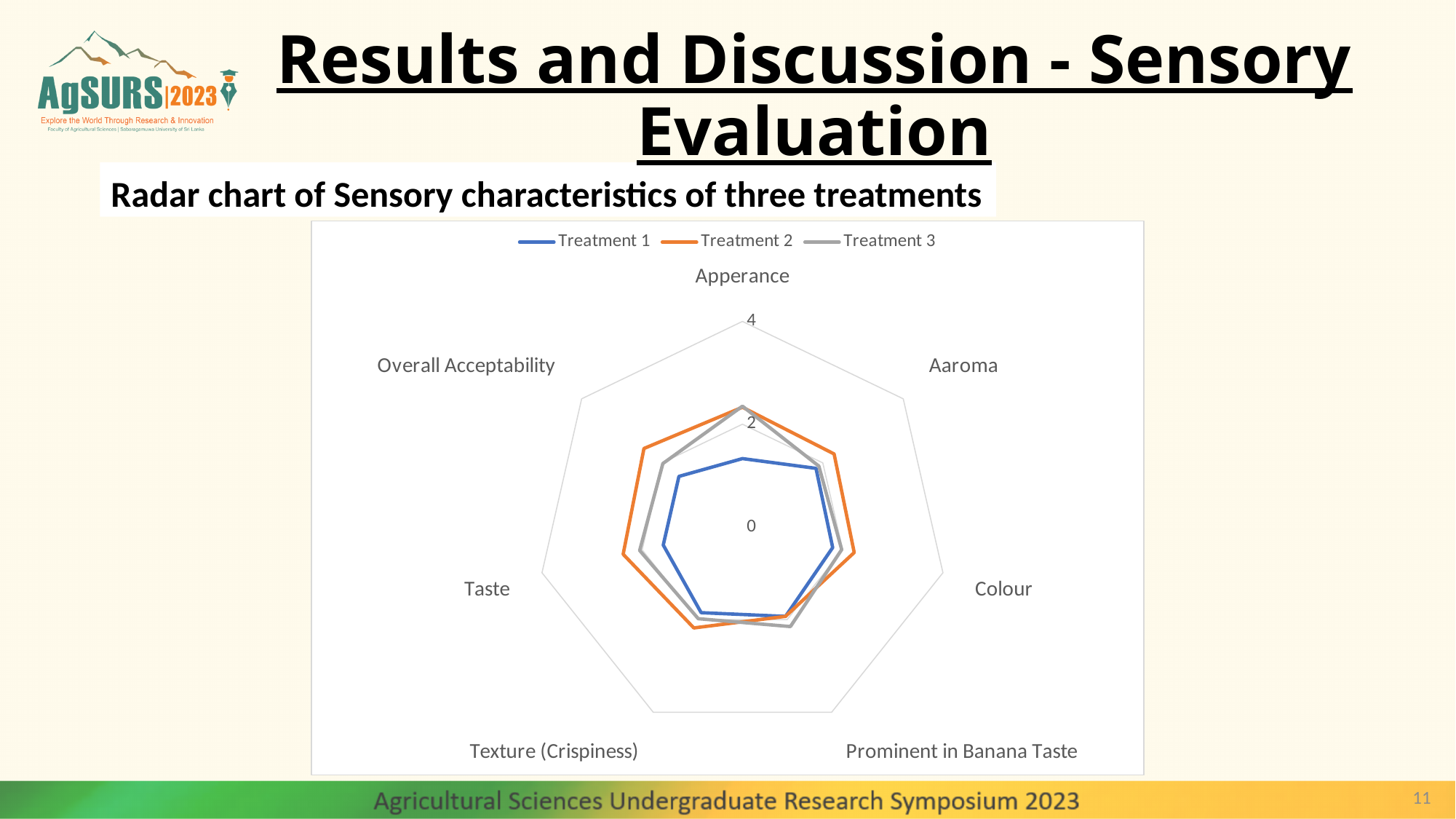
Which treatment has the lowest value for Apperance? Treatment 1 How many series does the legend list? 3 Which colour represents Treatment 2 in the legend? Orange What kind of chart is shown on the slide? Radar chart Which is larger for Apperance: Treatment 1 or Treatment 2? Treatment 2 Which is larger for Overall Acceptability: Treatment 1 or Treatment 3? Treatment 3 How many sensory characteristics (axes) are plotted on the radar chart? 7 Which is larger for Taste: Treatment 1 or Treatment 2? Treatment 2 What is the maximum value shown on the radar chart's axis scale? 4 Is the value of Treatment 1 for Apperance greater or less than 2? less Is the value of Treatment 1 for Taste greater or less than 2? less